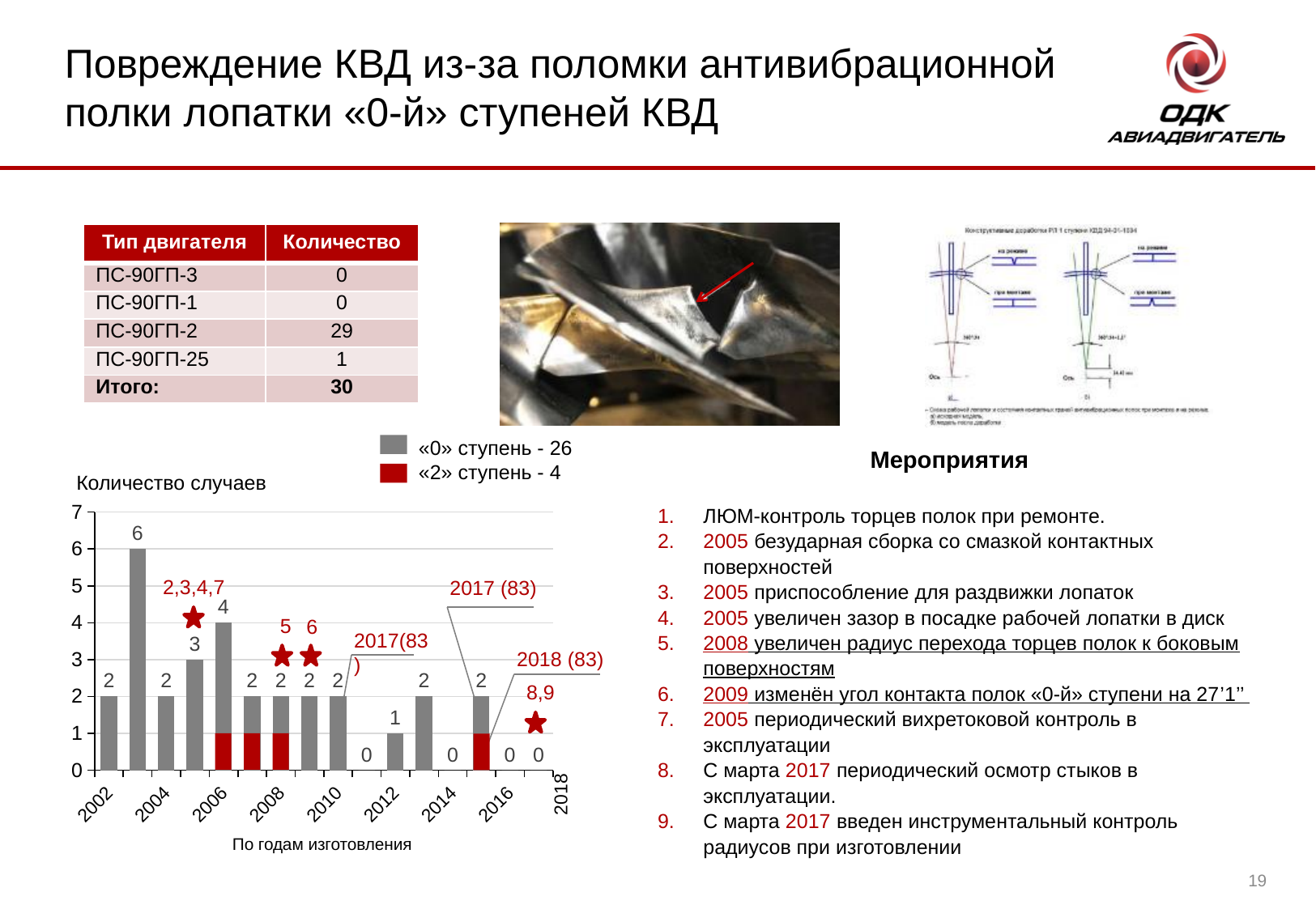
What is the highest value shown in the chart? 6 What is the number of cases for the 2002 bar in the chart? 2 What is the difference between the 2003 value and the 2006 value in the chart? 2 How many series does the chart legend list? 2 Is the value for 2003 in the chart greater or less than 5? greater What is the number of cases for the 2006 bar in the chart? 4 What kind of chart is shown on the slide? bar chart What are the two legend entries of the chart? «0» ступень - 26 and «2» ступень - 4 What is the title of the chart's vertical axis? Количество случаев What is the number of cases for the 2012 bar in the chart? 1 Which is larger in the chart, the value for 2005 or the value for 2006? 2006 Which year of manufacture has the highest number of cases in the chart? 2003